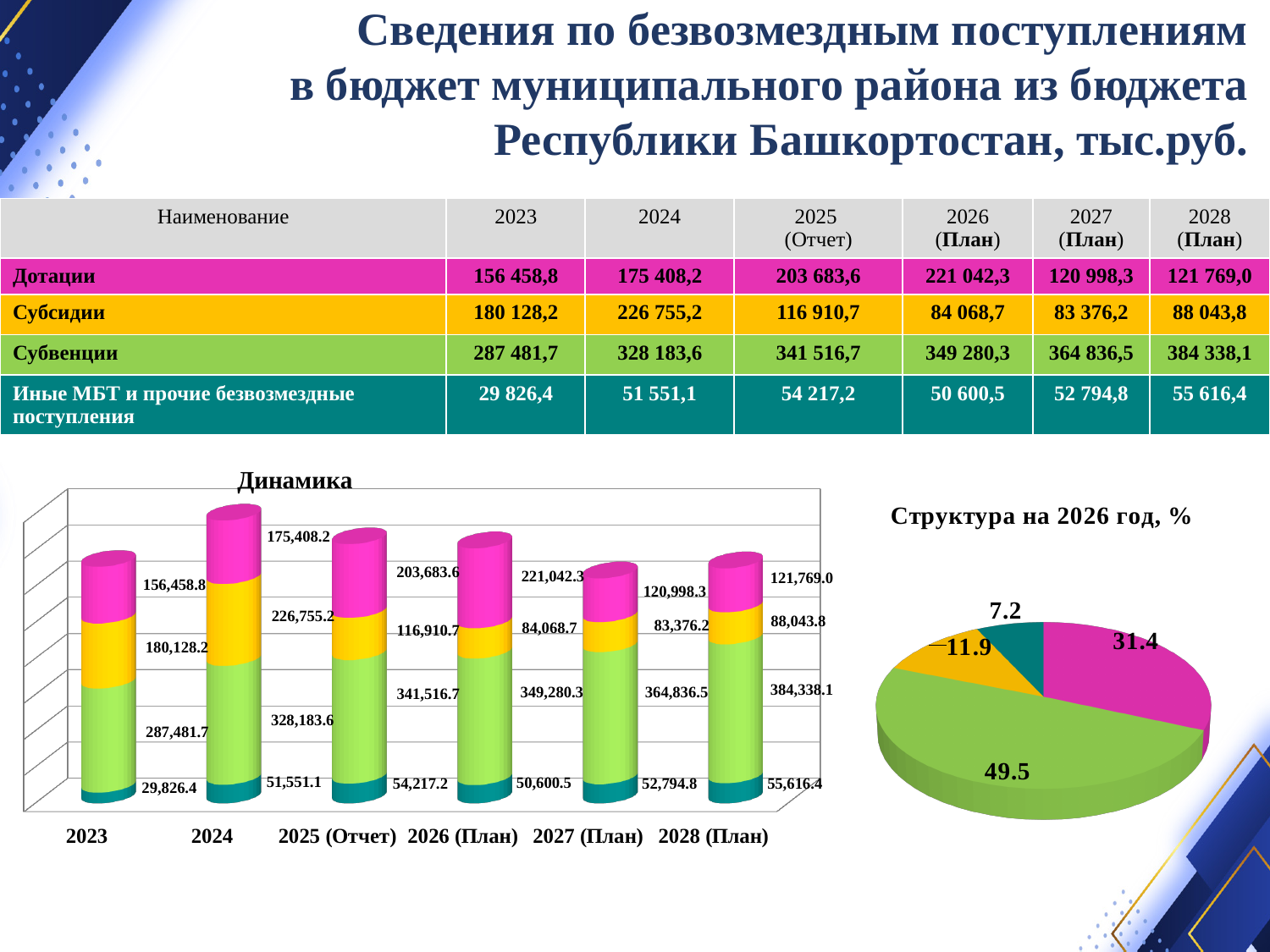
In the "Динамика" chart, what is the value of the green (Субвенции) segment for 2027 (План)? 364,836.5 In the "Динамика" chart, what is the value of the teal bottom segment for 2023? 29,826.4 In the "Динамика" chart, which is larger: the pink (Дотации) segment for 2024 or for 2025 (Отчет)? 2025 (Отчет) In the "Динамика" chart, what is the total of the stacked bar for 2023? 653,895.1 In the "Динамика" chart, how many year categories are shown on the x axis? 6 In the "Динамика" chart, does the green (Субвенции) segment rise or fall from 2023 to 2028 (План)? Rises In the "Структура на 2026 год, %" pie chart, how many slices are there? 4 What type of chart is "Структура на 2026 год, %" on the right? Pie chart In the "Динамика" chart, what is the difference between the green (Субвенции) segment for 2028 (План) and for 2023? 96,856.4 In the "Динамика" chart, what is the value of the yellow (Субсидии) segment for 2026 (План)? 84,068.7 In the "Структура на 2026 год, %" pie chart, which slice is the largest? 49.5 What type of chart is the "Динамика" chart on the left? Stacked bar chart